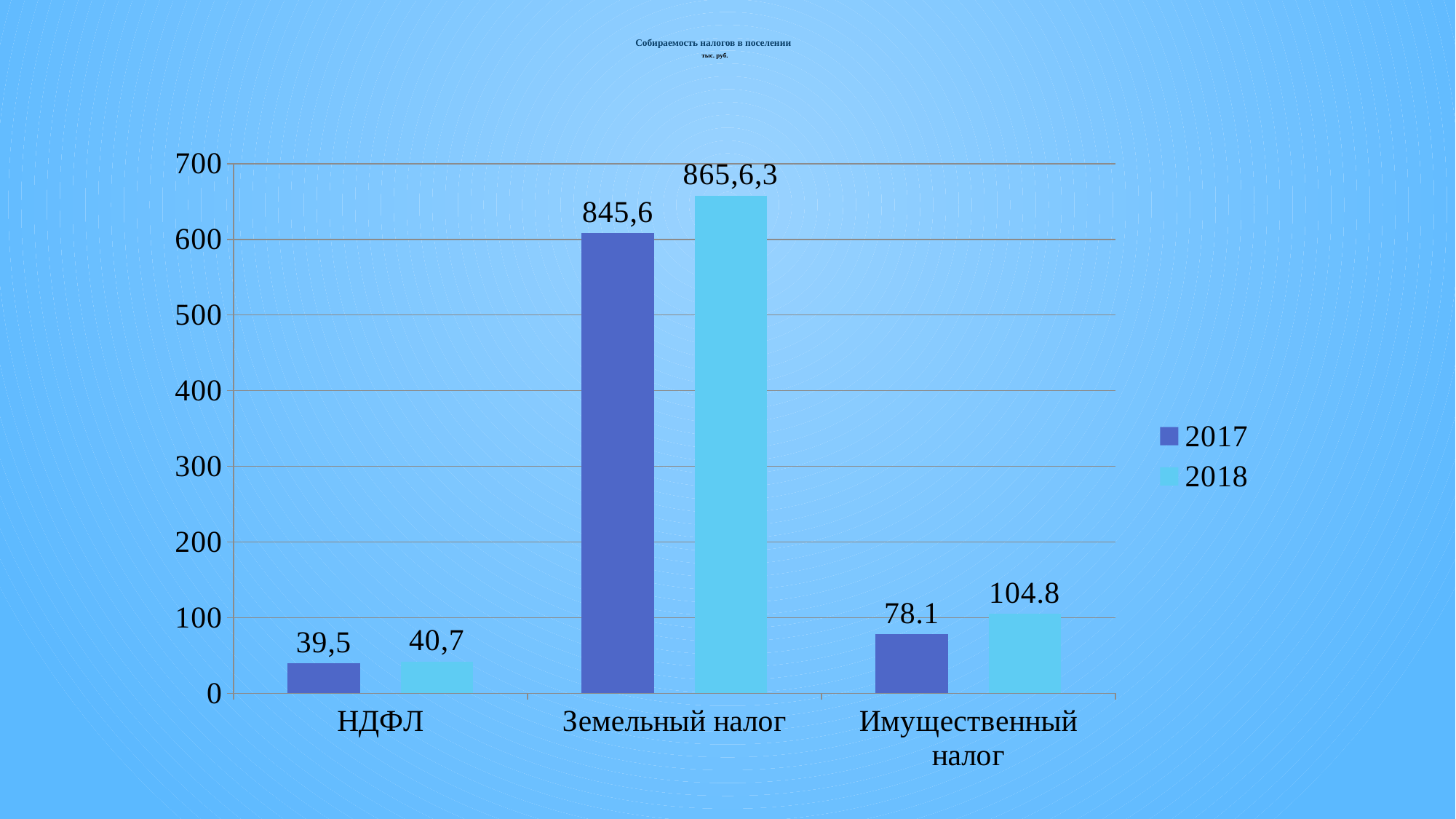
Which category has the lowest value in 2017? НДФЛ What is the value for Земельный налог in 2017? 845,6 How many series does the legend list? 2 How many categories are shown on the x axis? 3 What is the value for Имущественный налог in 2018? 104.8 What is the value for Имущественный налог in 2017? 78.1 Is the 2018 bar for Земельный налог greater or less than 600? greater What is the value for НДФЛ in 2017? 39,5 Which category has the highest value in 2018? Земельный налог What is the value for НДФЛ in 2018? 40,7 For Имущественный налог, which year has the larger value, 2017 or 2018? 2018 What is the difference between the 2018 and 2017 values for Имущественный налог? 26.7